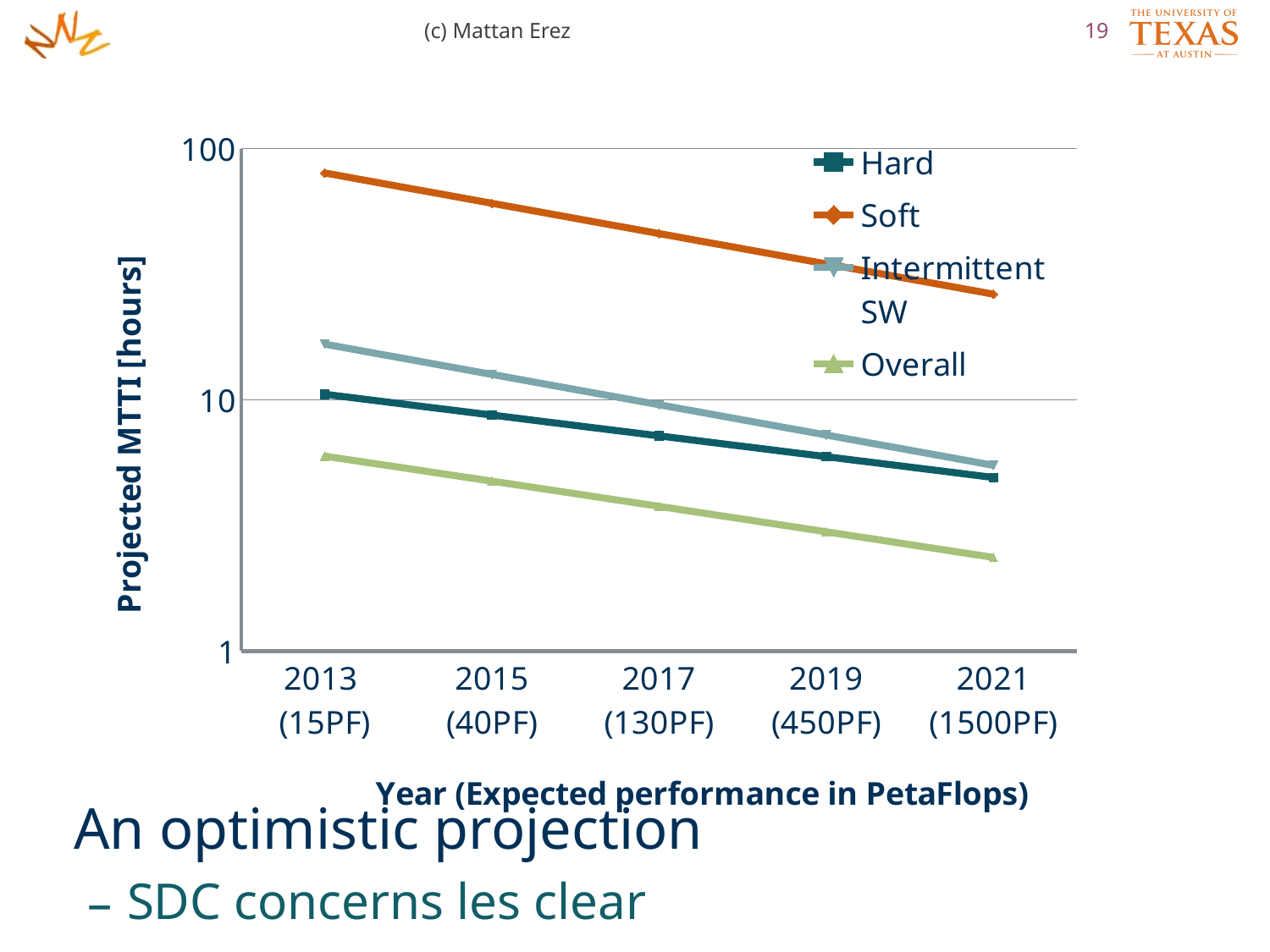
How many series does the legend list? 4 Is the value for Soft in 2021 greater or less than 100? less Does the Soft series rise or fall from 2013 to 2021? fall What is the label of the y axis? Projected MTTI [hours] What kind of chart is shown on the slide? line chart Which series has the highest projected MTTI in 2013? Soft Is the value for Soft in 2013 greater or less than 10? greater Is the value for Hard in 2021 greater or less than 10? less In 2013, which is larger: the value for Intermittent SW or the value for Hard? Intermittent SW Which series has the lowest projected MTTI in 2021? Overall How many years are plotted along the x axis? 5